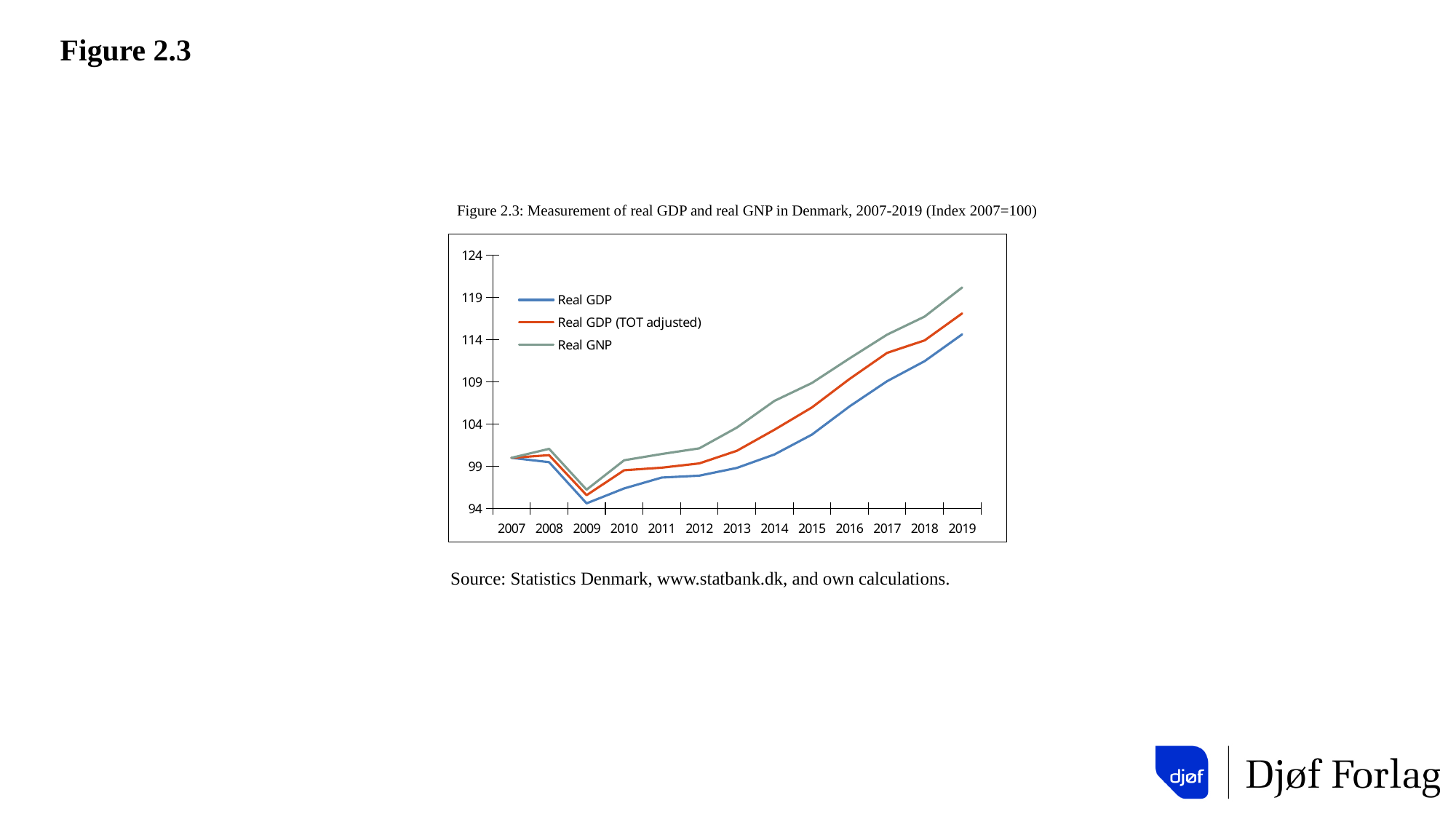
Is the value for Real GNP in 2019 greater or less than 119? greater In which year does the Real GDP series reach its lowest value? 2009 How many series does the legend list? 3 Do the series generally rise or fall from 2009 to 2019? rise In 2019, which is larger: Real GNP or Real GDP? Real GNP Is the value for Real GNP in 2018 greater or less than 114? greater What kind of chart is shown on the slide? line chart Is the value for Real GDP in 2009 greater or less than 99? less Which colour is used for the Real GDP line? blue In which year does the Real GNP series reach its highest value? 2019 How many years are plotted along the x axis? 13